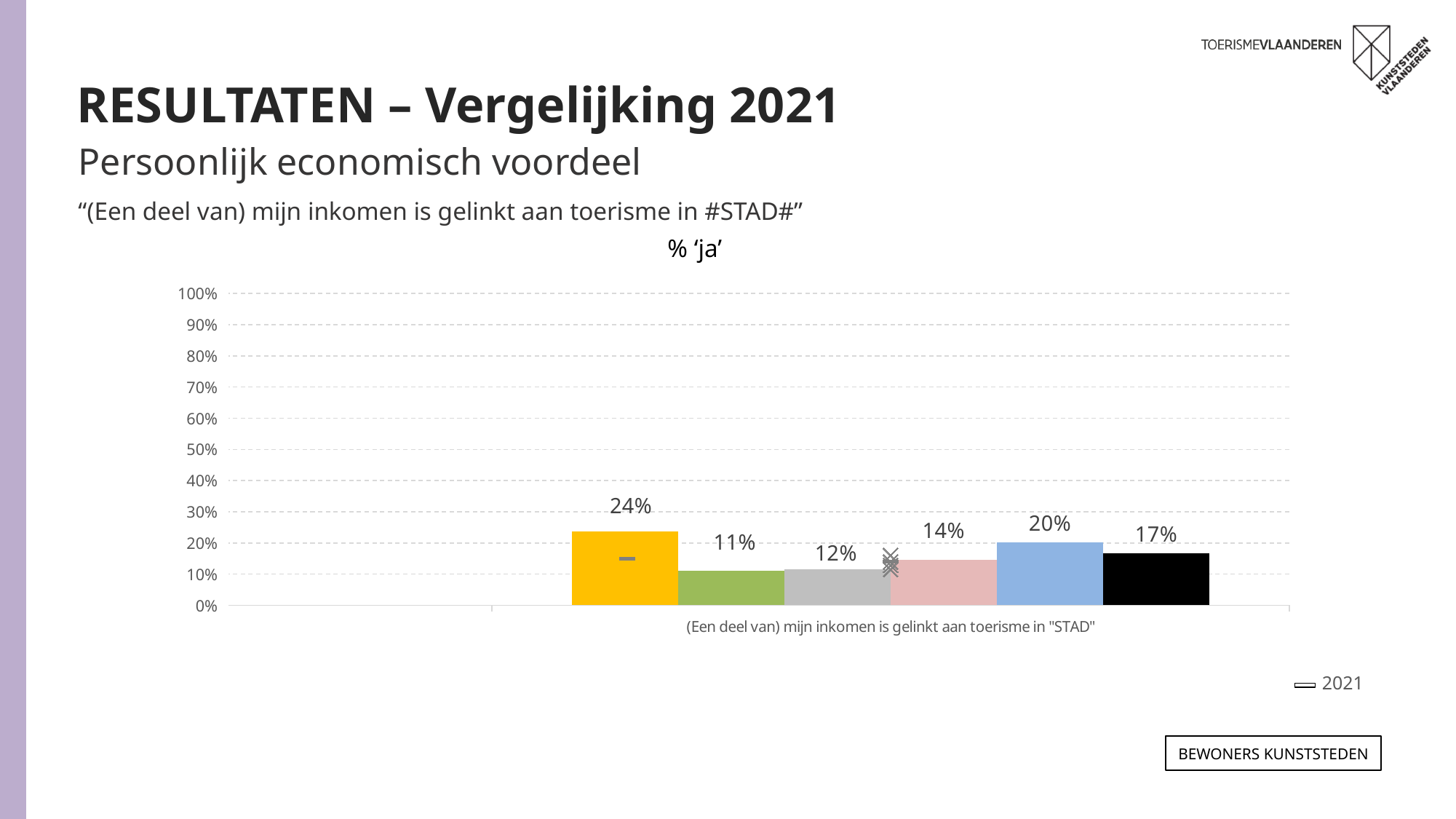
What value is shown on the black bar? 17% What value is shown on the yellow bar? 24% Which bar has the lowest value? The green bar (11%) What kind of chart is shown on the slide? Bar chart What is the difference between the blue bar and the black bar? 3 percentage points Is the value of the yellow bar greater or less than 20%? greater What is the title of the chart? % 'ja' Which is larger, the pink bar or the grey bar? The pink bar (14%) What is the difference between the yellow bar and the green bar? 13 percentage points Which bar has the highest value? The yellow bar (24%) How many bars are plotted in the chart? 6 What value is shown on the blue bar? 20%